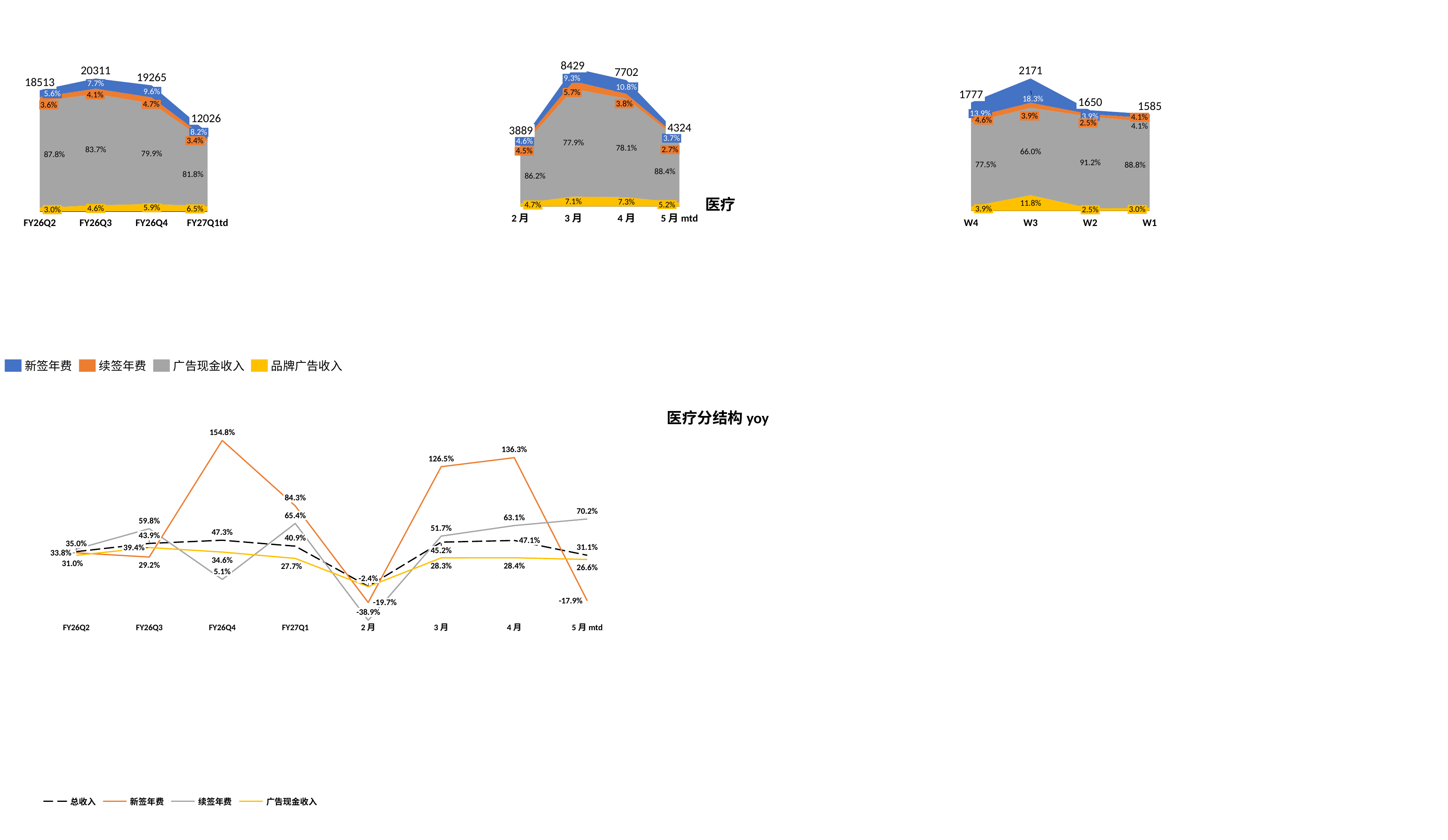
In the bottom chart titled 医疗分结构 yoy, what is the 总收入 value for FY26Q4? 47.3% What kind of chart is the bottom chart titled 医疗分结构 yoy? Line chart How many series does the legend of the top stacked charts list? 4 In the top-left chart, what is the total value shown for FY26Q3? 20311 In the top-middle chart, what share does 新签年费 have in 4月? 10.8% In the top-left chart, which period has the lowest total value? FY27Q1td In the top-right chart, what share does 品牌广告收入 have in W3? 11.8% In the bottom chart titled 医疗分结构 yoy, what is the highest value of the 新签年费 line and at which period? 154.8% at FY26Q4 In the top-right chart, which week has the highest total value? W3 In the top-middle chart, what is the total value for 3月? 8429 In the top-left chart, what share does 广告现金收入 have in FY26Q2? 87.8% In the top-middle chart, what is the difference between the totals for 3月 and 4月? 727